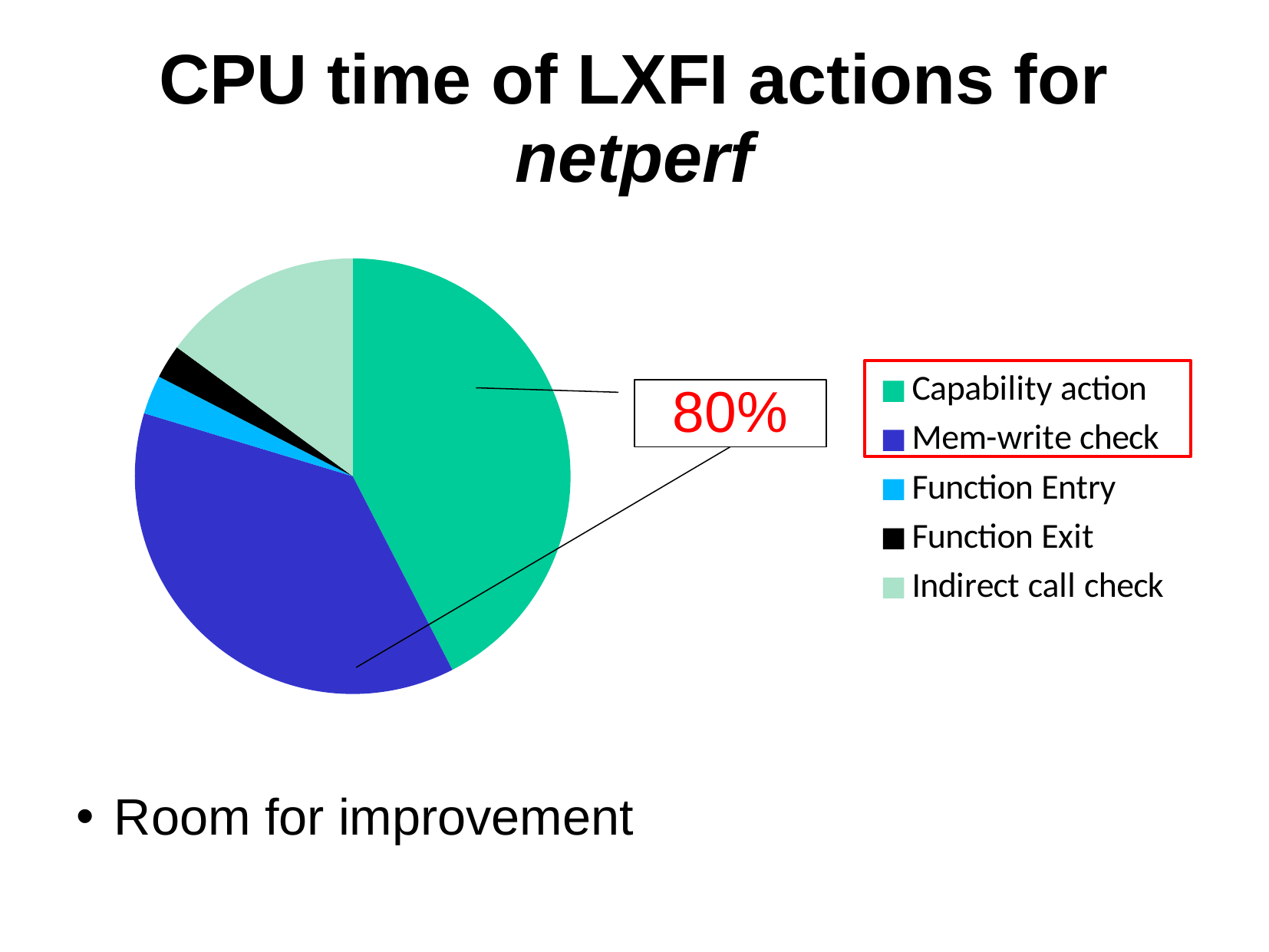
Which category has the second-largest share of the pie chart? Mem-write check Which slice is larger: Capability action or Indirect call check? Capability action What kind of chart is shown on the slide? pie chart What is the title of the slide containing the pie chart? CPU time of LXFI actions for netperf How many entries does the legend of the pie chart list? 5 Which category takes the largest share of the pie chart? Capability action Which two legend entries are enclosed in the red box? Capability action and Mem-write check Which slice is larger: Indirect call check or Function Exit? Indirect call check Which slice is larger: Mem-write check or Function Entry? Mem-write check According to the annotation on the chart, what combined share of CPU time do Capability action and Mem-write check account for? 80% How many slices does the pie chart have? 5